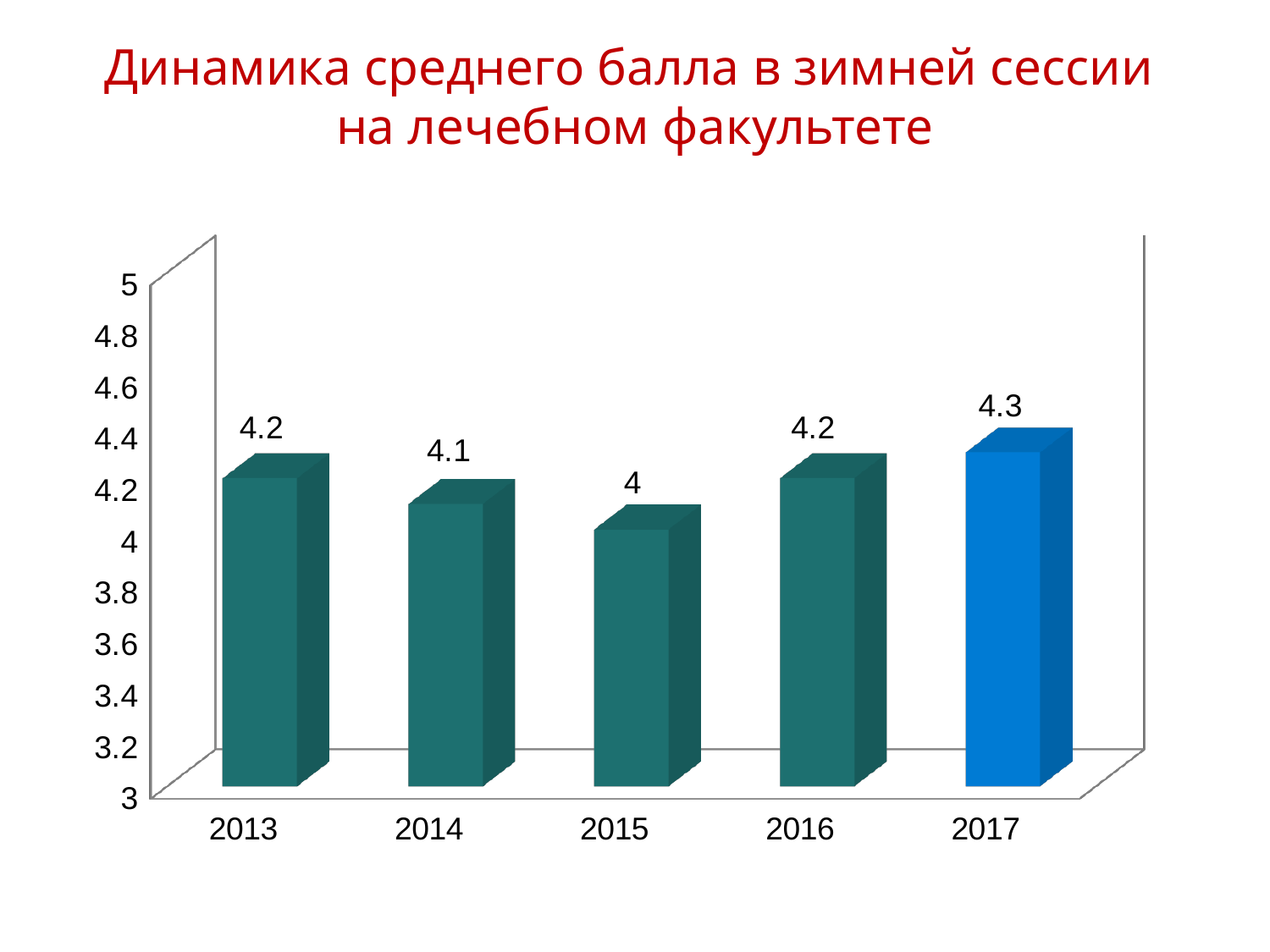
What is the title of the chart on the slide? Динамика среднего балла в зимней сессии на лечебном факультете What is the value for 2017? 4.3 Which bar is coloured differently from the others? 2017 What kind of chart is shown on the slide? bar chart What is the value for 2015? 4 What is the value for 2013? 4.2 Which is larger, the value for 2014 or the value for 2016? 2016 Which year has the lowest value? 2015 Which year has the highest value? 2017 How many years are shown on the x axis? 5 What is the difference between the values for 2017 and 2015? 0.3 Do the values rise or fall from 2015 to 2017? rise